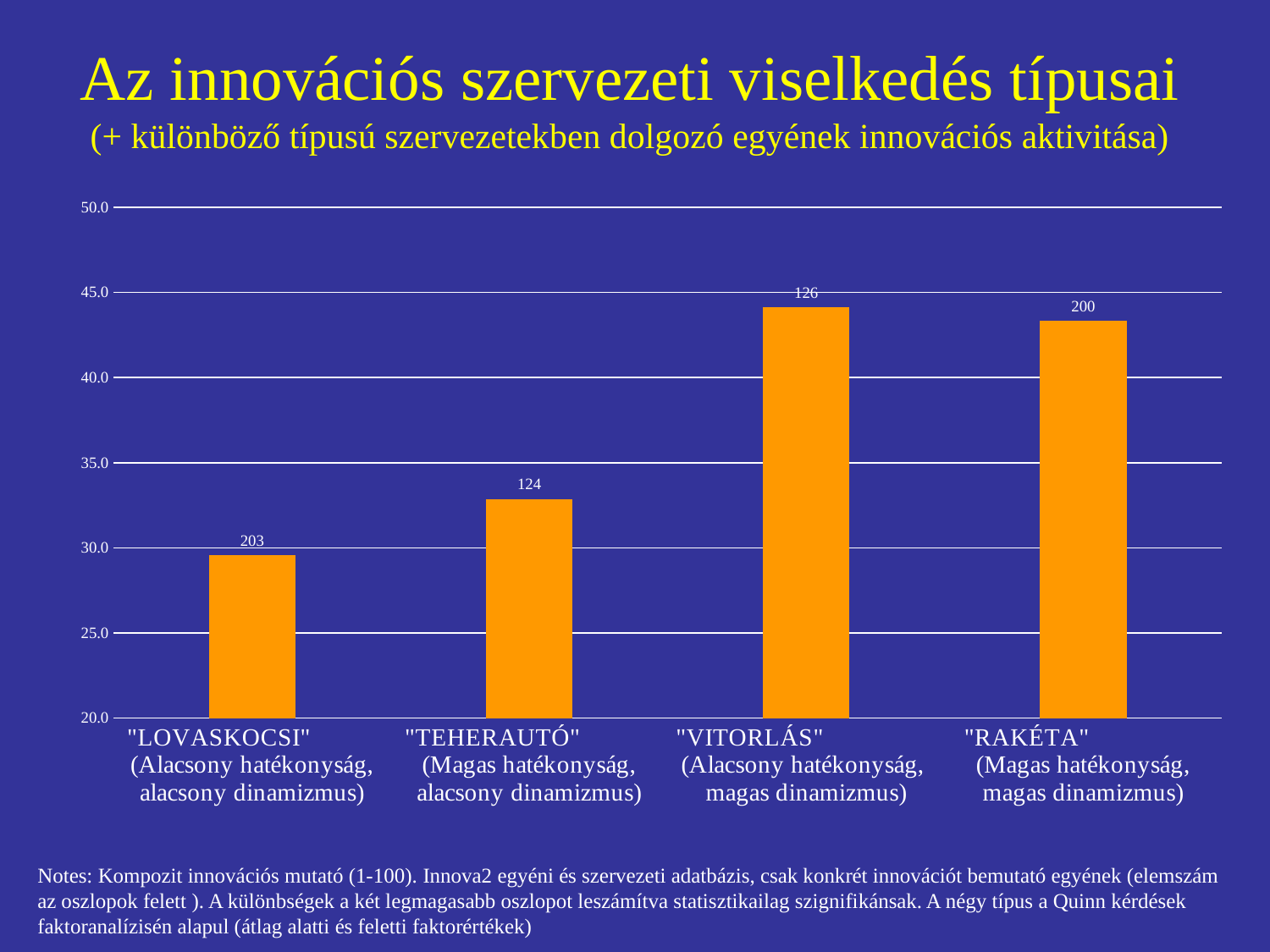
Is the value for "TEHERAUTÓ" greater or less than 30? greater Which category has the highest bar? "VITORLÁS" What number (sample size) is printed above the bar for "TEHERAUTÓ"? 124 Is the value for "VITORLÁS" greater or less than 40? greater Which has the larger value, "RAKÉTA" or "LOVASKOCSI"? "RAKÉTA" Is the value for "RAKÉTA" greater or less than 45? less Which category has the lowest bar? "LOVASKOCSI" What kind of chart is shown on the slide? bar chart What is the highest value shown on the y axis? 50.0 Which has the larger value, "TEHERAUTÓ" or "LOVASKOCSI"? "TEHERAUTÓ" How many categories (organisation types) are shown on the x axis? 4